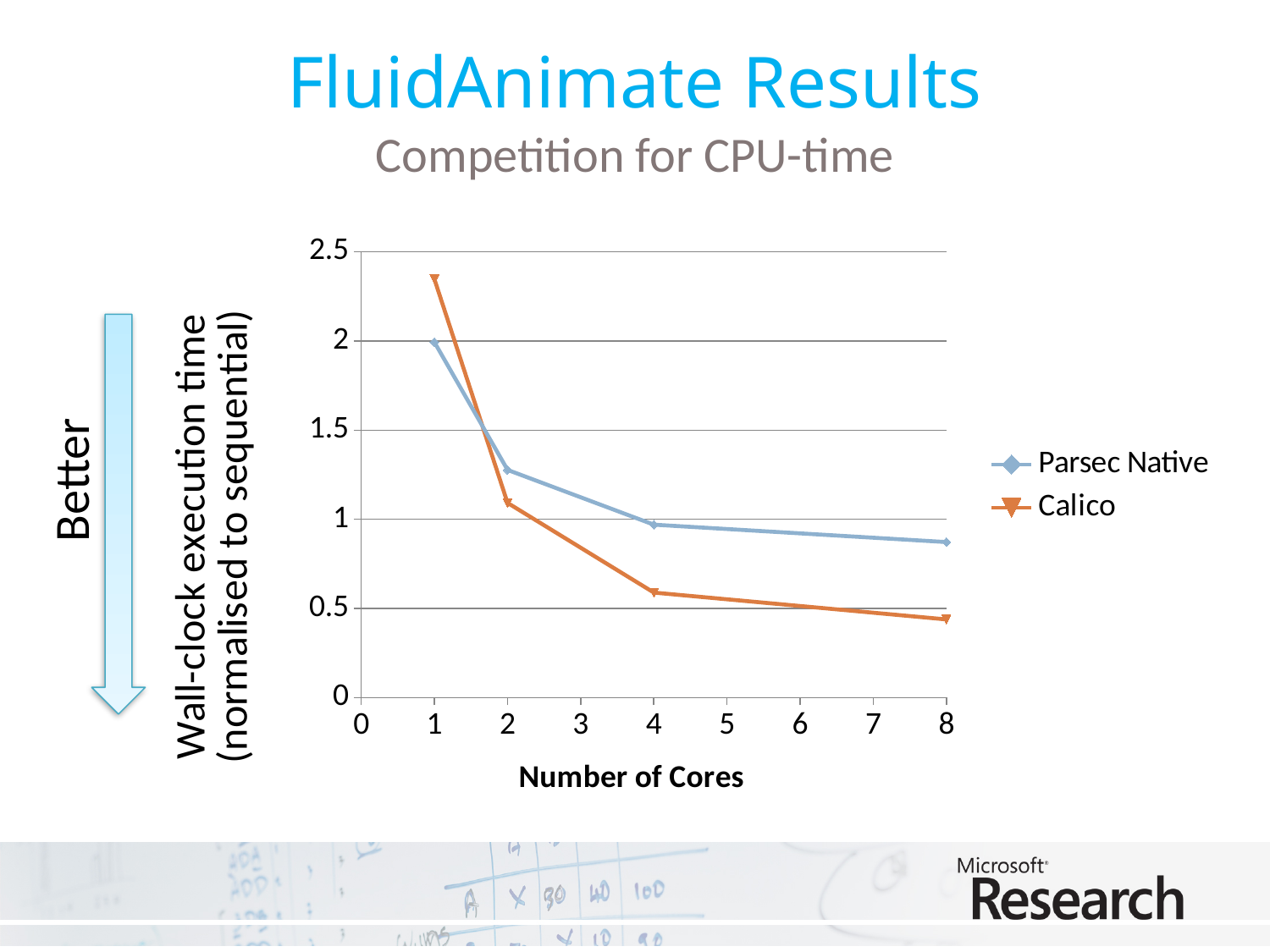
Is the value for Parsec Native at 8 cores greater or less than 1? less How many data points are plotted for the Calico series? 4 Does the Parsec Native series rise or fall as the number of cores increases? fall What is the title of the x axis? Number of Cores Is the value for Calico at 8 cores greater or less than 0.5? less Is the value for Parsec Native at 2 cores greater or less than 1? greater At 1 core, which series has the higher wall-clock execution time, Parsec Native or Calico? Calico What kind of chart is shown on the slide? line chart At 8 cores, which series has the lower wall-clock execution time, Parsec Native or Calico? Calico How many series does the legend list? 2